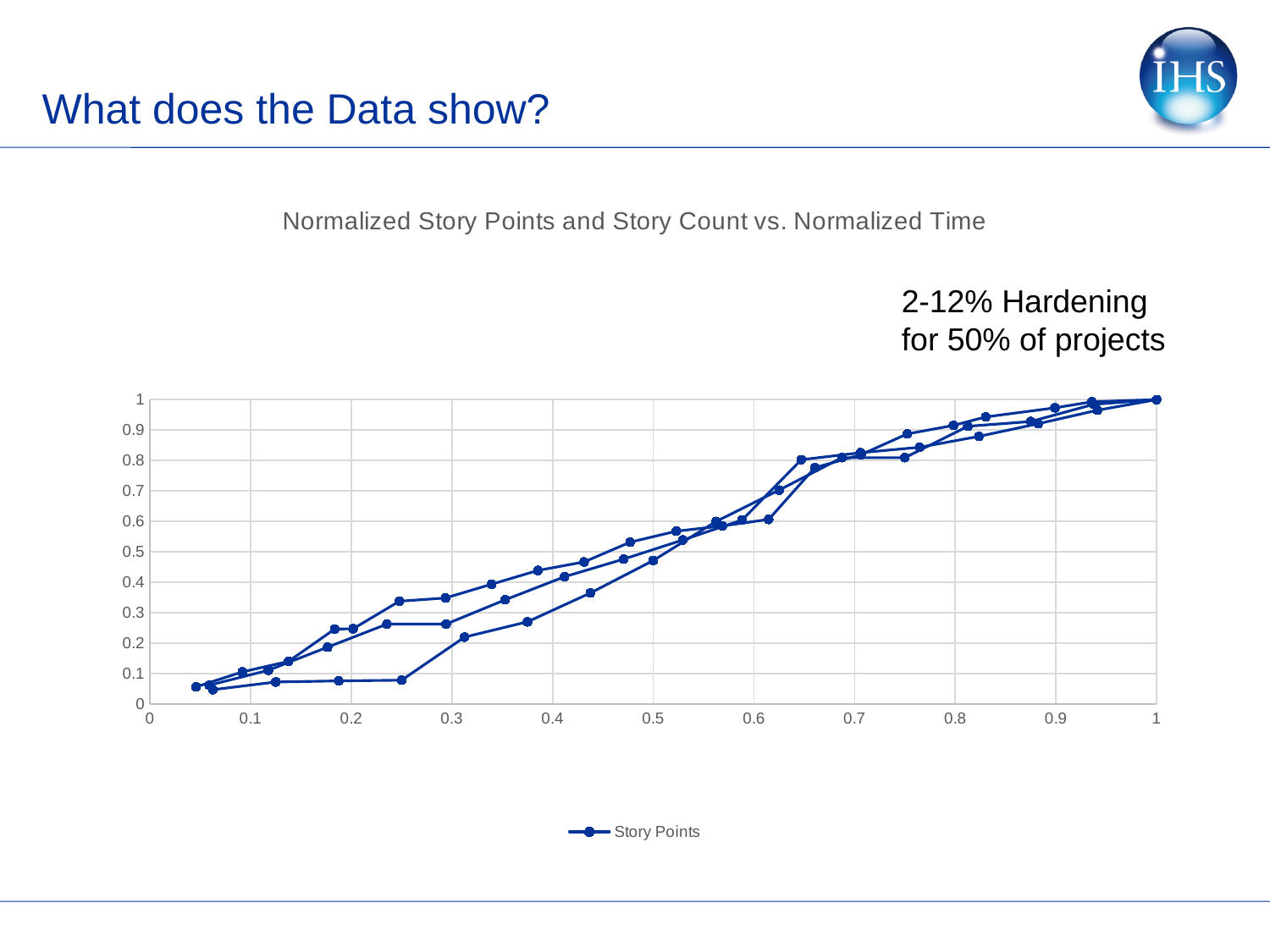
At a normalized time of 0.2, are the plotted values greater or less than 0.4? less What is the title of the chart? Normalized Story Points and Story Count vs. Normalized Time How many series does the chart legend list? 1 What is the highest value shown on the y axis? 1 What is the lowest value shown on the x axis? 0 At a normalized time of 0.3, are the plotted values greater or less than 0.5? less What kind of chart is shown on the slide? Line chart At a normalized time of 0.9, are the plotted values greater or less than 0.8? greater What is the name of the series listed in the legend? Story Points What value do the lines reach at a normalized time of 1? 1 Do the plotted values rise or fall as normalized time increases along the x axis? Rise